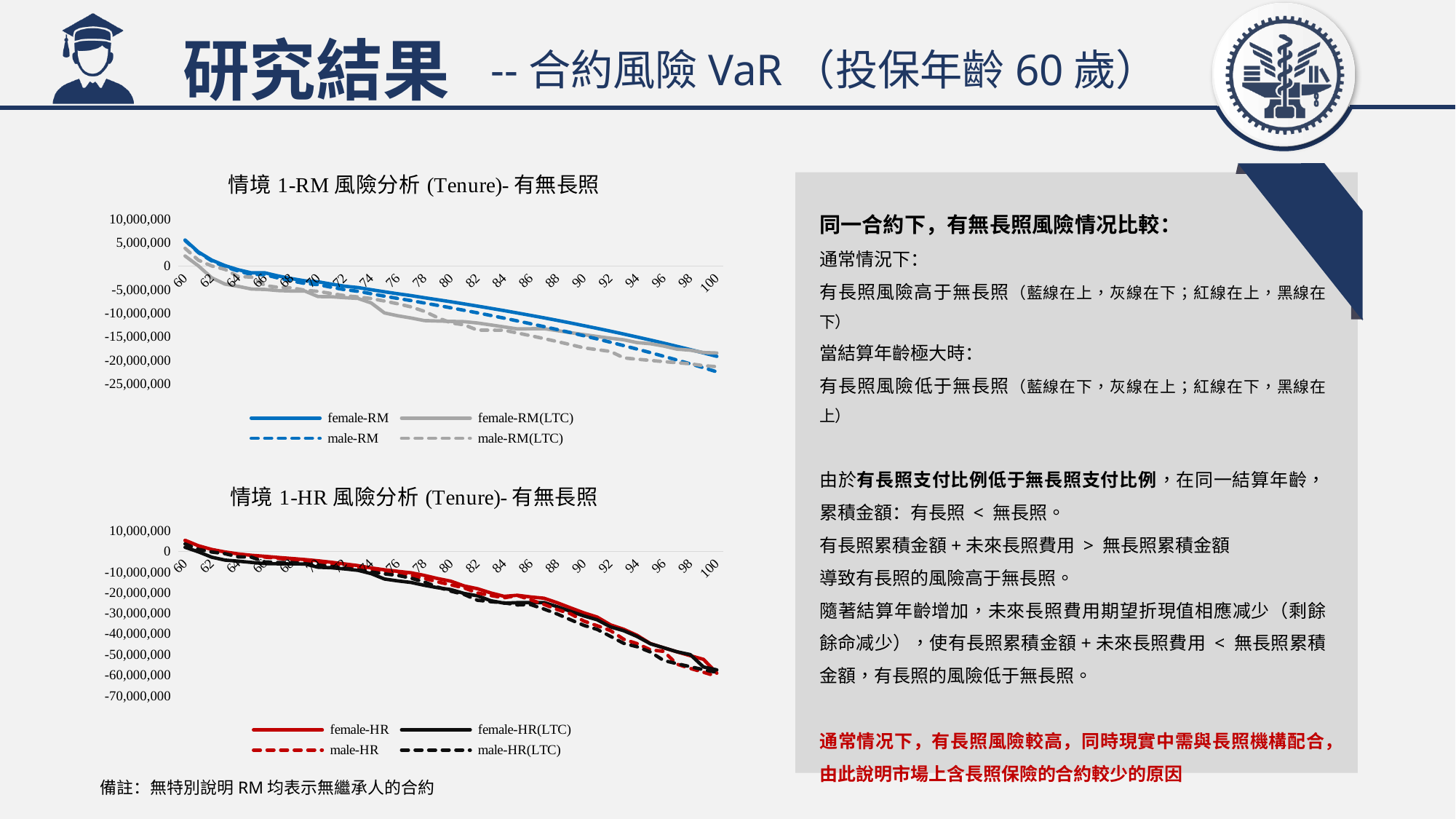
How many age labels are shown on the x axis of the top chart (情境 1-RM 風險分析)? 21 How many series does the legend of the bottom chart (情境 1-HR 風險分析) list? 4 In the bottom chart (情境 1-HR 風險分析), do the values of female-HR rise or fall along the x axis? fall In the top chart (情境 1-RM 風險分析), is the value for male-RM at age 100 greater or less than -20,000,000? less What kind of chart is the top chart titled 情境 1-RM 風險分析 (Tenure)- 有無長照? line chart In the bottom chart (情境 1-HR 風險分析), which series is drawn as a solid red line? female-HR In the top chart (情境 1-RM 風險分析), which is higher at age 70: female-RM or female-RM(LTC)? female-RM In the top chart (情境 1-RM 風險分析), do the values of female-RM rise or fall as age increases from 60 to 100? fall In the top chart (情境 1-RM 風險分析), is the value for female-RM at age 60 greater or less than 0? greater How many series does the legend of the top chart (情境 1-RM 風險分析) list? 4 What is the lowest value shown on the y axis of the bottom chart (情境 1-HR 風險分析)? -70,000,000 In the bottom chart (情境 1-HR 風險分析), is the value for female-HR at age 100 greater or less than -50,000,000? less